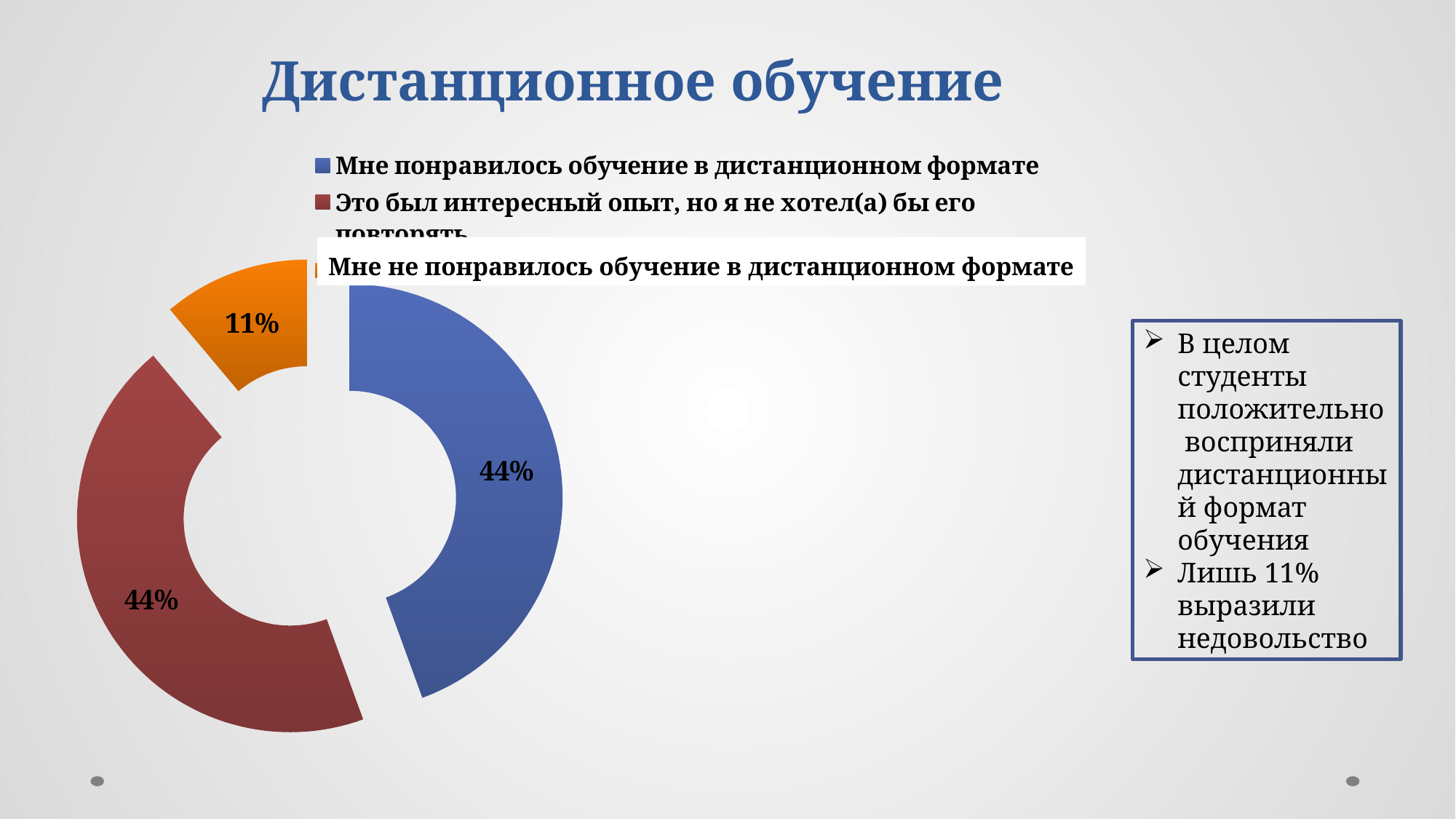
What percentage of respondents chose "Мне понравилось обучение в дистанционном формате"? 44% How many categories are shown in the chart? 3 Which colour represents "Мне понравилось обучение в дистанционном формате" in the chart? Blue Which response has the smallest share in the chart? Мне не понравилось обучение в дистанционном формате How many entries does the chart legend list? 3 Which is larger: the share for "Мне понравилось обучение в дистанционном формате" or the share for "Мне не понравилось обучение в дистанционном формате"? Мне понравилось обучение в дистанционном формате What is the difference in percentage points between the share for "Это был интересный опыт, но я не хотел(а) бы его повторять" and the share for "Мне не понравилось обучение в дистанционном формате"? 33 percentage points What is the title of the slide containing the chart? Дистанционное обучение What kind of chart is shown on the slide? Doughnut (pie) chart What share of the chart does the orange slice represent? 11% What percentage of respondents chose "Мне не понравилось обучение в дистанционном формате"? 11% What percentage of respondents chose "Это был интересный опыт, но я не хотел(а) бы его повторять"? 44%